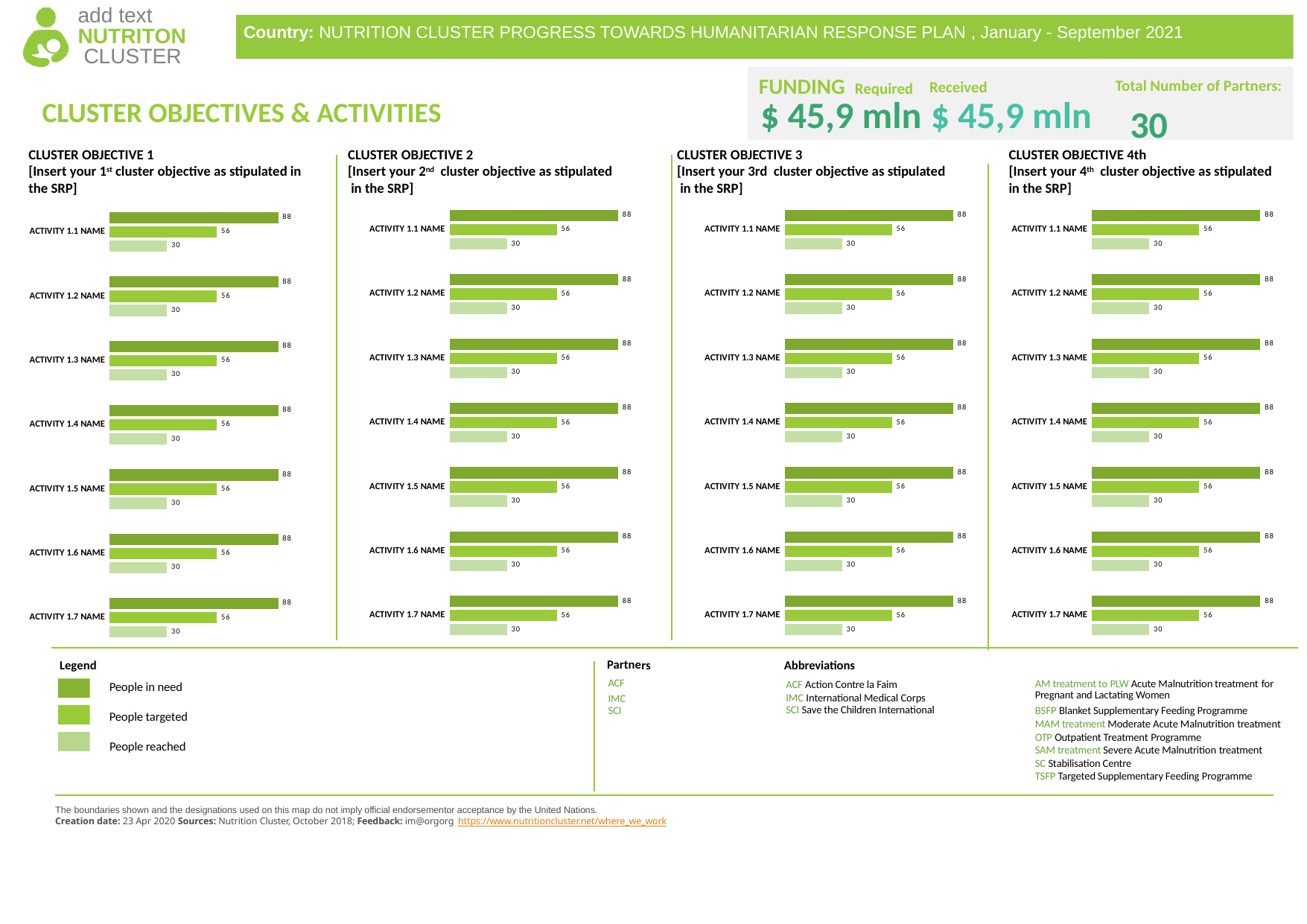
In the Cluster Objective 1 chart, what is the People in need value for ACTIVITY 1.1 NAME? 88 According to the legend, which series is shown in the darkest green? People in need In the Cluster Objective 2 chart, what is the difference between People targeted and People reached for ACTIVITY 1.4 NAME? 26 In the Cluster Objective 4th chart, which series has the lowest value for ACTIVITY 1.1 NAME? People reached How many series does the legend list for the activity charts? 3 In the Cluster Objective 2 chart, what is the People targeted value for ACTIVITY 1.3 NAME? 56 In the Cluster Objective 1 chart, what is the difference between People in need and People reached for ACTIVITY 1.2 NAME? 58 How many activities are plotted in the Cluster Objective 1 chart? 7 In the Cluster Objective 3 chart, which is larger for ACTIVITY 1.6 NAME: People in need or People targeted? People in need In the Cluster Objective 4th chart, what is the People in need value for ACTIVITY 1.5 NAME? 88 What type of chart is used for Cluster Objective 4th? Bar chart In the Cluster Objective 3 chart, what is the People reached value for ACTIVITY 1.7 NAME? 30